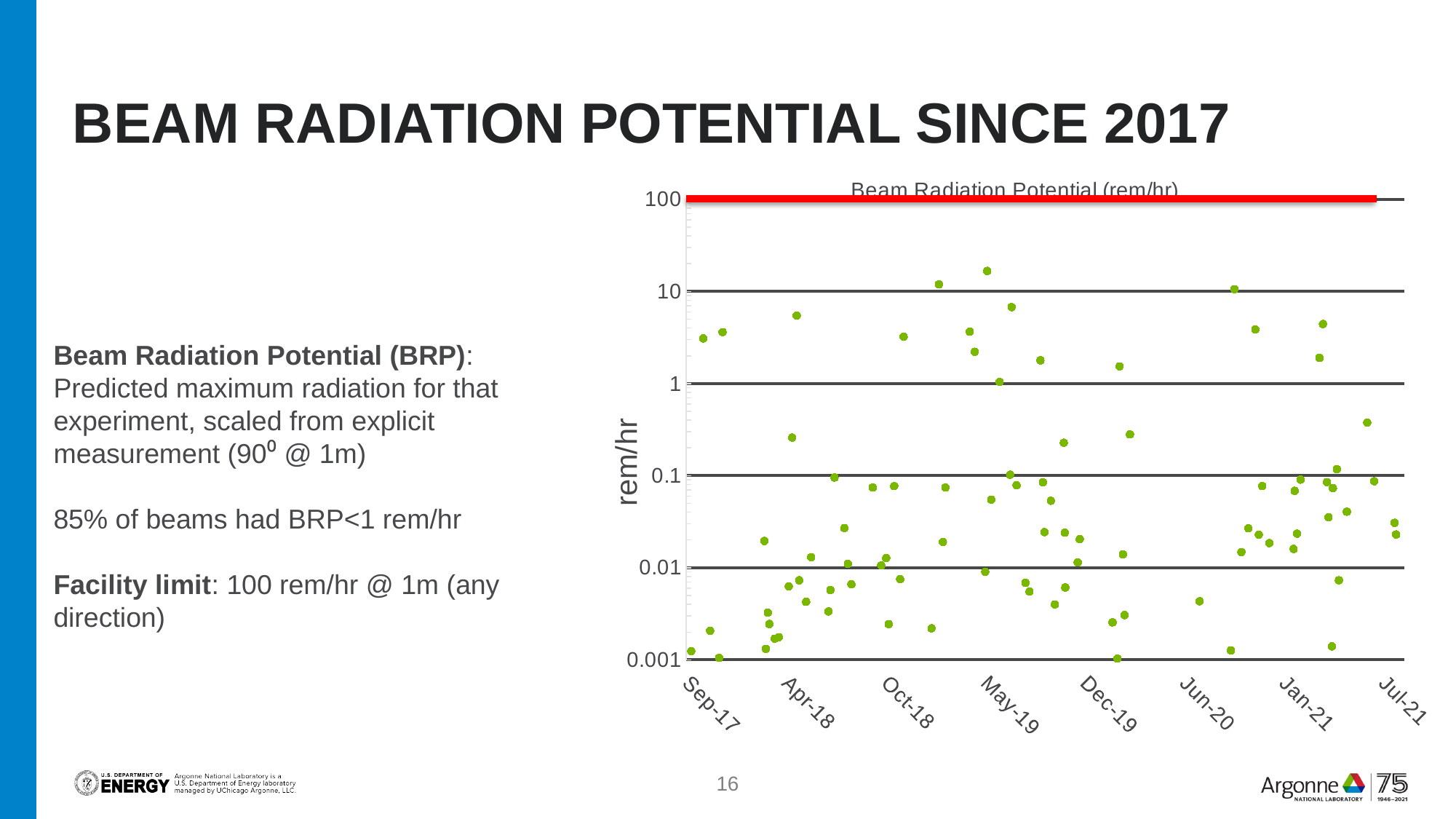
What is the lowest tick value shown on the chart's y axis? 0.001 What is the last date label on the chart's x axis? Jul-21 What is the title of the chart? Beam Radiation Potential (rem/hr) Is the highest plotted point on the chart greater or less than 100 rem/hr? less What is the label on the chart's y axis? rem/hr What is the highest tick value shown on the chart's y axis? 100 What kind of chart is shown on the slide? scatter chart Is the lowest plotted point on the chart greater or less than 0.01 rem/hr? less At what y-axis value is the red horizontal line drawn on the chart? 100 Is the highest plotted point on the chart greater or less than 10 rem/hr? greater What is the first date label on the chart's x axis? Sep-17 How many date labels are shown along the chart's x axis? 8